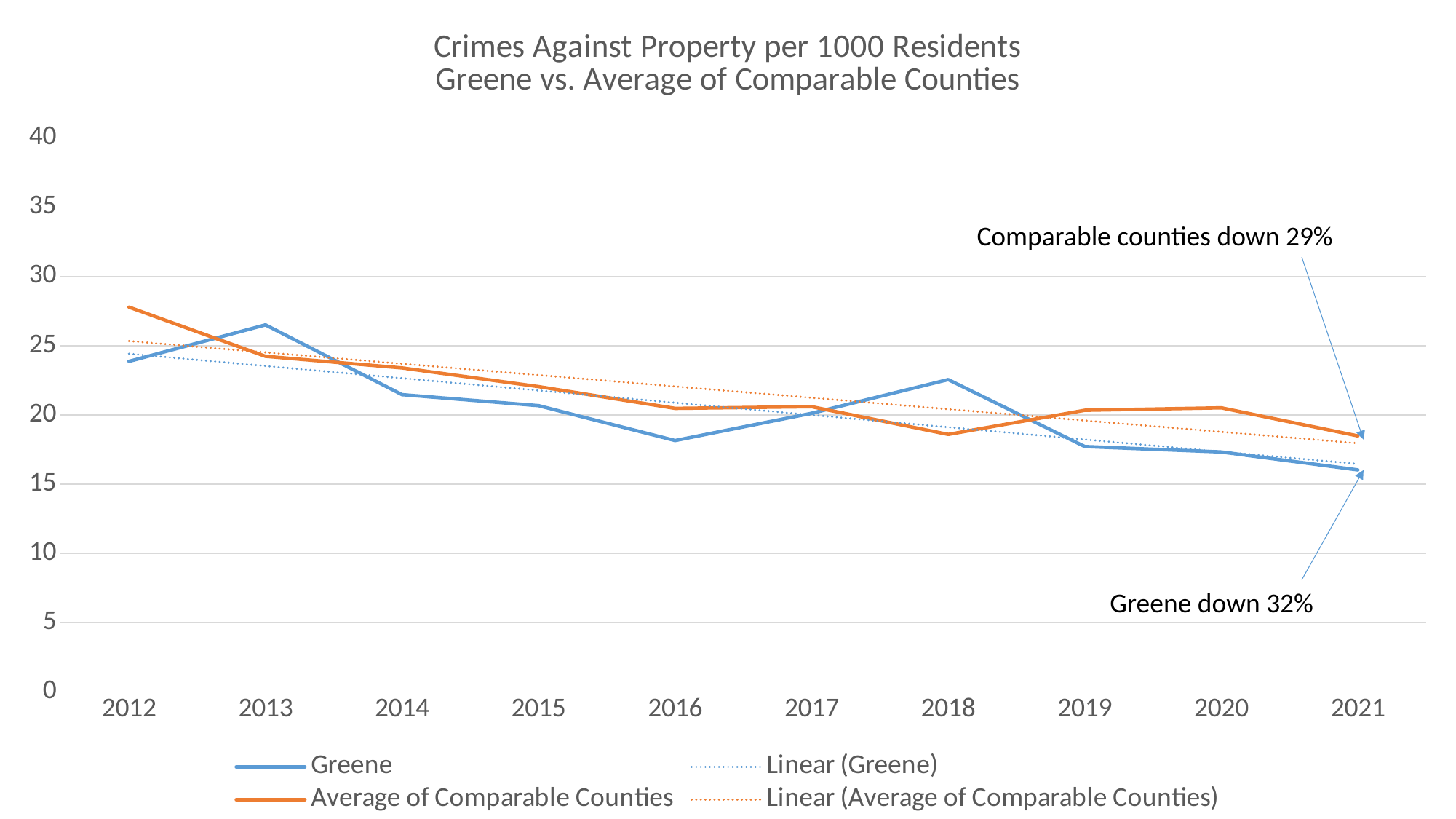
In which year is the Greene line at its highest? 2013 How many years are plotted along the x axis? 10 In which year is the Average of Comparable Counties line at its highest? 2012 In 2018, which is higher: Greene or Average of Comparable Counties? Greene Is the value for Greene in 2013 greater or less than 25? greater Is the value for Greene in 2016 greater or less than 20? less In which year is the Greene line at its lowest? 2021 How many entries does the legend list? 4 What kind of chart is shown on the slide? line chart Is the value for Average of Comparable Counties in 2012 greater or less than 25? greater Does the Greene line generally rise or fall from 2012 to 2021? fall